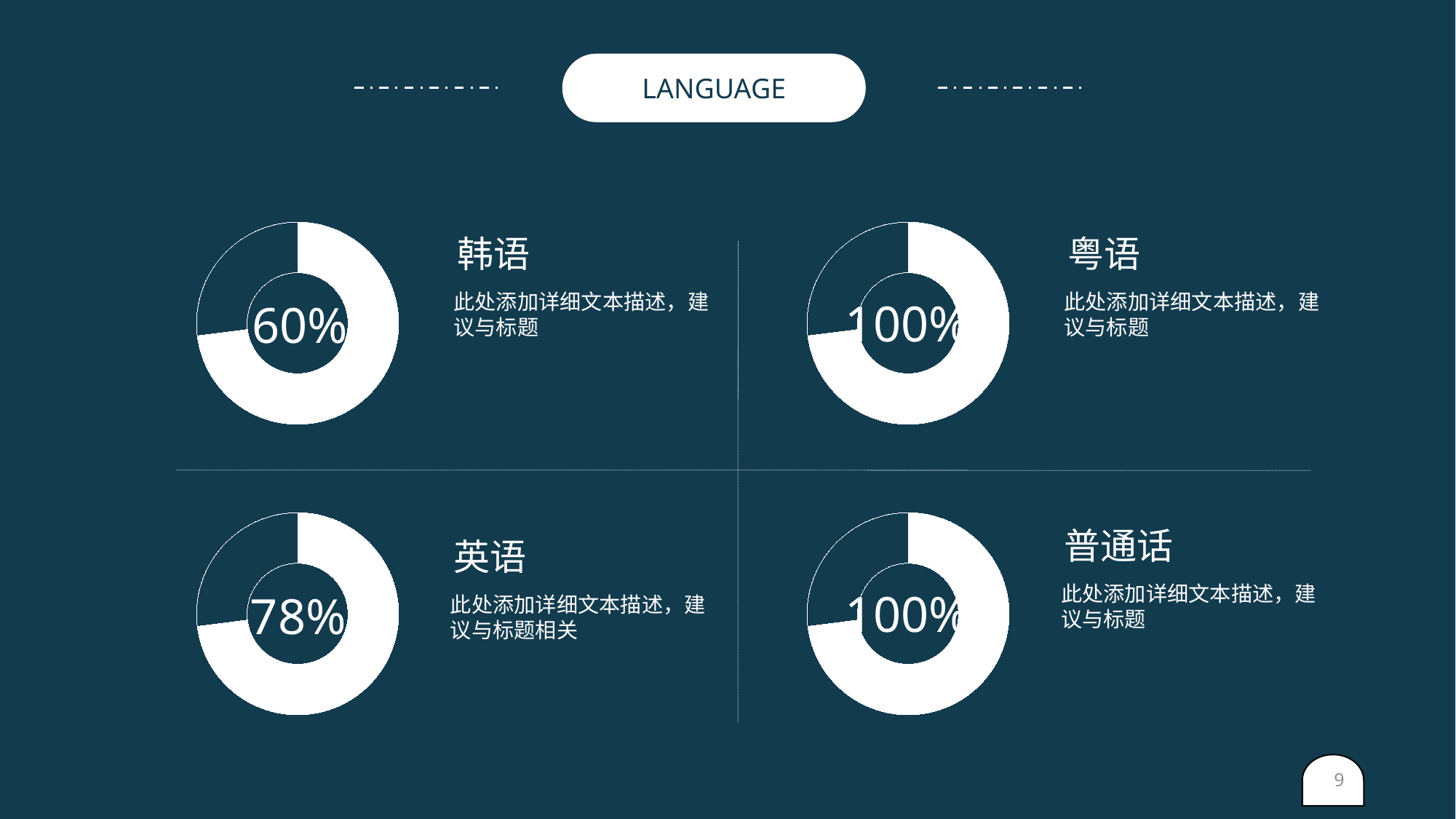
Which has the larger percentage, 韩语 or 英语? 英语 What kind of chart is used to show each language's percentage? Donut chart How many donut charts are on the slide? 4 What is the difference between the percentages shown for 英语 and 韩语? 18% What percentage is shown for 普通话 (Mandarin)? 100% What percentage is shown for 粤语 (Cantonese)? 100% Which language has the lowest percentage shown on the slide? 韩语 What is the heading text in the rounded box at the top of the slide? LANGUAGE What is the difference between the percentages shown for 粤语 and 英语? 22% What percentage is shown for 韩语 (Korean)? 60% What percentage is shown for 英语 (English)? 78% How many languages are shown with a percentage of 100%? 2